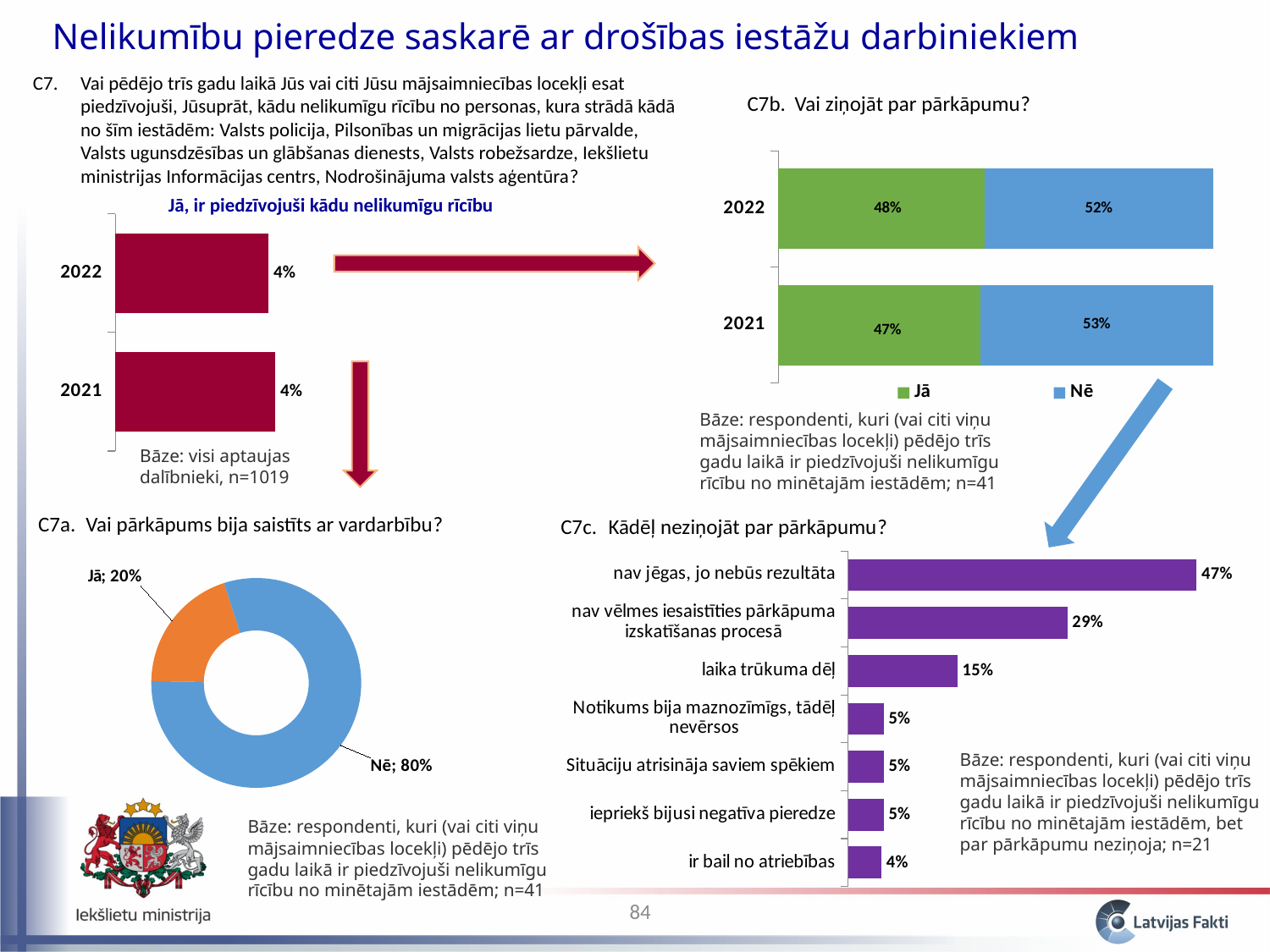
In the C7c chart "Kādēļ neziņojāt par pārkāpumu?", what is the difference between "nav jēgas, jo nebūs rezultāta" and "nav vēlmes iesaistīties pārkāpuma izskatīšanas procesā"? 18% In the C7a chart "Vai pārkāpums bija saistīts ar vardarbību?", what share does "Nē" have? 80% In the C7c chart "Kādēļ neziņojāt par pārkāpumu?", what is the value for "laika trūkuma dēļ"? 15% What kind of chart is the C7a chart "Vai pārkāpums bija saistīts ar vardarbību?"? Donut (pie) chart In the C7c chart "Kādēļ neziņojāt par pārkāpumu?", which category has the lowest value? ir bail no atriebības In the C7c chart "Kādēļ neziņojāt par pārkāpumu?", how many categories are shown? 7 In the C7b chart "Vai ziņojāt par pārkāpumu?", what is the value for "Jā" in 2022? 48% In the C7b chart "Vai ziņojāt par pārkāpumu?", what is the total of the 2022 stacked bar? 100% In the C7b chart "Vai ziņojāt par pārkāpumu?", what is the value for "Nē" in 2021? 53% In the chart "Jā, ir piedzīvojuši kādu nelikumīgu rīcību", what is the value for 2022? 4% In the C7c chart "Kādēļ neziņojāt par pārkāpumu?", which category has the highest value? nav jēgas, jo nebūs rezultāta In the C7b chart "Vai ziņojāt par pārkāpumu?", how many series does the legend list? 2